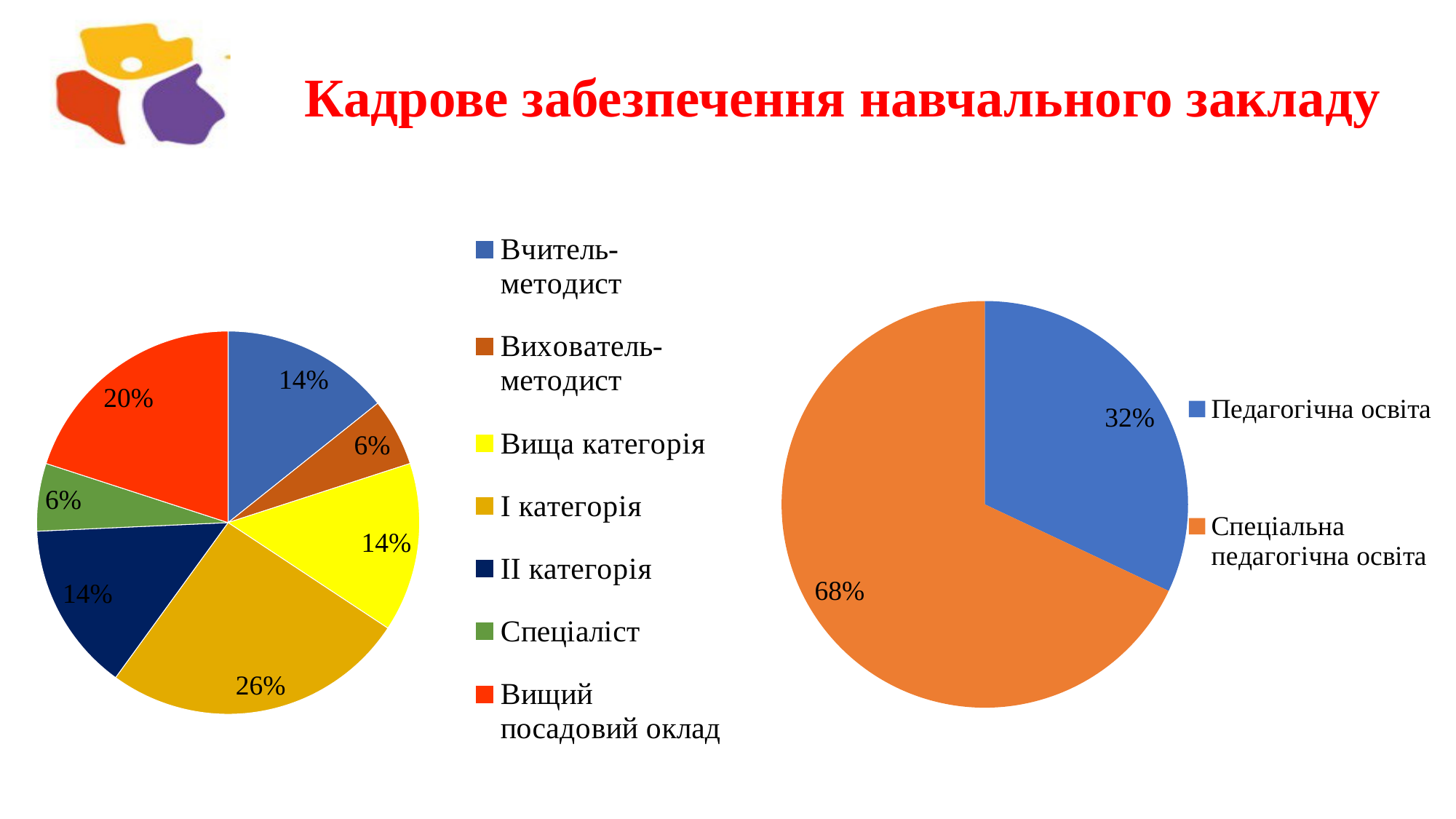
On the right pie chart, what is the difference between the shares of "Спеціальна педагогічна освіта" and "Педагогічна освіта"? 36% On the left pie chart, what share does "Вищий посадовий оклад" have? 20% On the left pie chart, how many categories does the legend list? 7 What type of chart is the right chart on the slide? Pie chart On the right pie chart, which category has the largest share? Спеціальна педагогічна освіта On the right pie chart, what share does "Педагогічна освіта" have? 32% On the left pie chart, which category has the largest share? I категорія On the left pie chart, what share does "Вихователь-методист" have? 6% On the left pie chart, what is the difference between the shares of "I категорія" and "Вищий посадовий оклад"? 6% On the left pie chart, which is larger: the share of "Вчитель-методист" or the share of "Спеціаліст"? Вчитель-методист On the left pie chart, what share does "I категорія" have? 26% On the right pie chart, what share does "Спеціальна педагогічна освіта" have? 68%